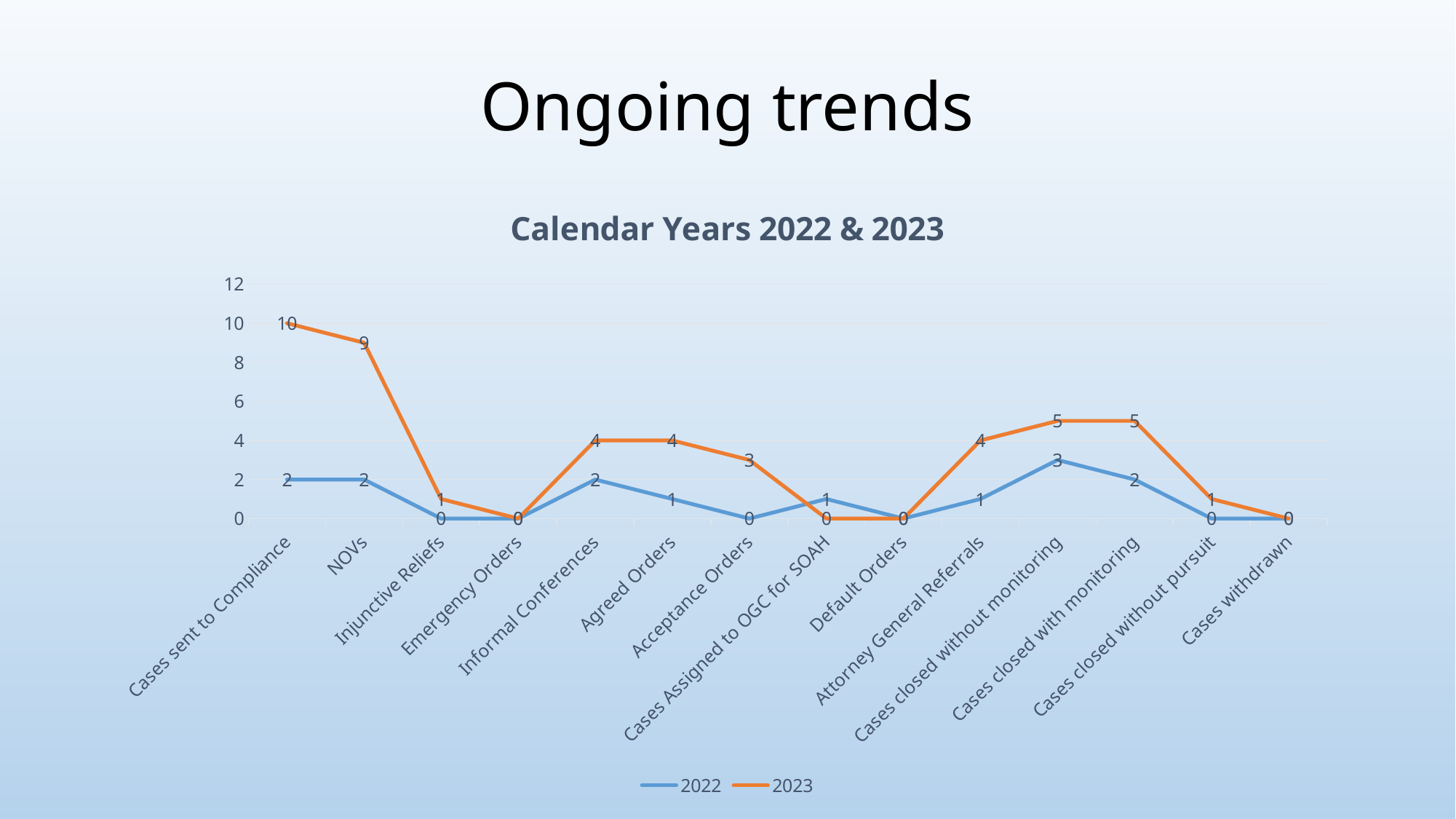
Which is larger for Cases Assigned to OGC for SOAH, the 2022 value or the 2023 value? 2022 What is the difference between the 2023 and 2022 values for NOVs? 7 Which category has the highest 2022 value? Cases closed without monitoring What type of chart is shown on the slide? Line chart What is the 2023 value for Cases sent to Compliance? 10 Which colour represents the 2023 series? Orange What is the 2023 value for NOVs? 9 What is the 2022 value for Cases closed without monitoring? 3 What is the title of the chart? Calendar Years 2022 & 2023 How many categories are shown on the x axis? 14 How many series does the legend list? 2 Which category has the highest 2023 value? Cases sent to Compliance